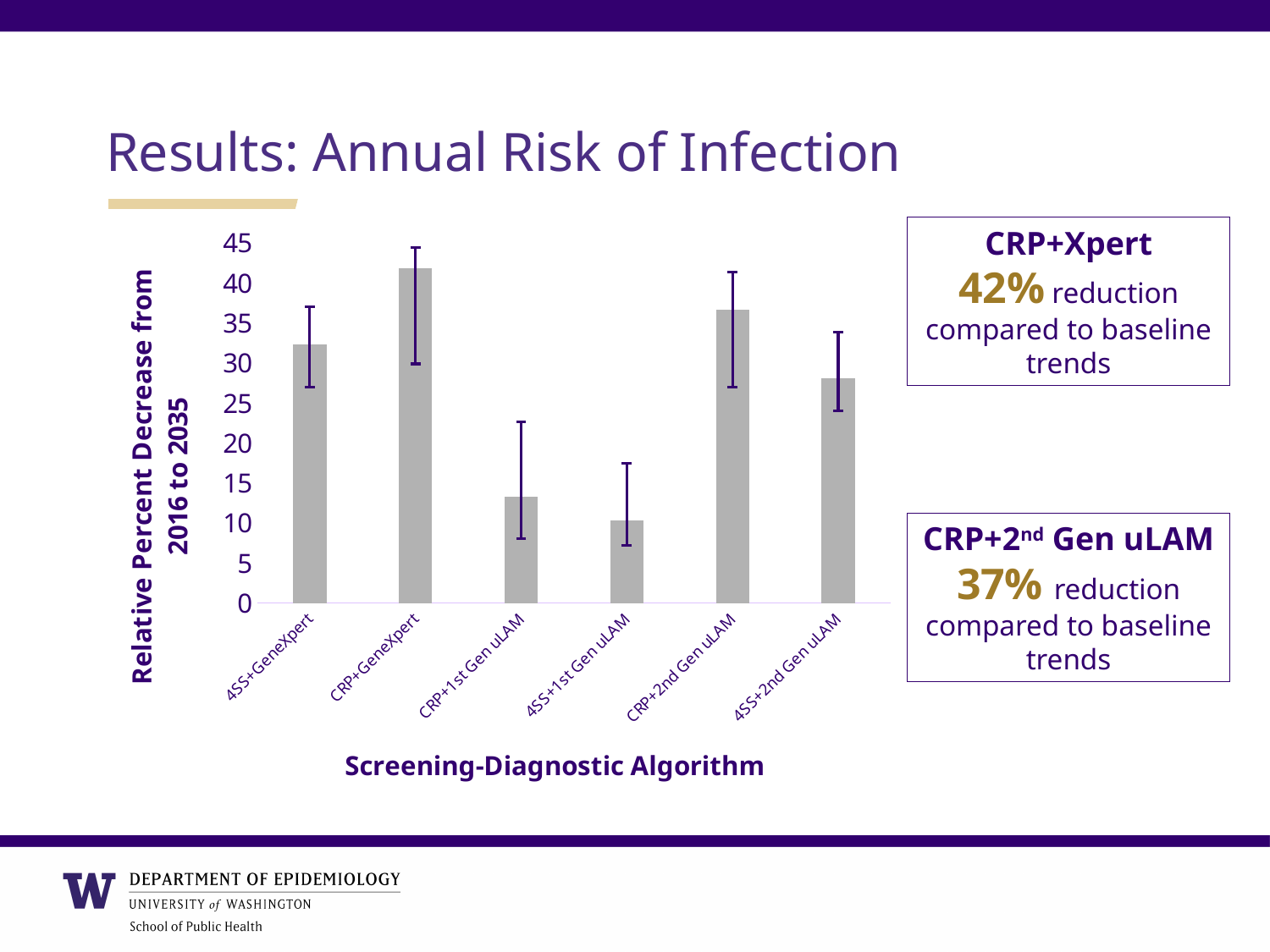
What is the title of the x axis of the chart? Screening-Diagnostic Algorithm Is the value for 4SS+2nd Gen uLAM greater or less than 30? less Is the value for CRP+GeneXpert greater or less than 40? greater Which has a larger relative percent decrease, CRP+GeneXpert or 4SS+GeneXpert? CRP+GeneXpert What kind of chart is shown on the slide? bar chart Which screening-diagnostic algorithm has the lowest relative percent decrease? 4SS+1st Gen uLAM Is the value for 4SS+GeneXpert greater or less than 30? greater How many screening-diagnostic algorithms are plotted on the chart? 6 Which has a larger relative percent decrease, CRP+2nd Gen uLAM or 4SS+1st Gen uLAM? CRP+2nd Gen uLAM Which screening-diagnostic algorithm has the highest relative percent decrease? CRP+GeneXpert What is the title of the y axis of the chart? Relative Percent Decrease from 2016 to 2035